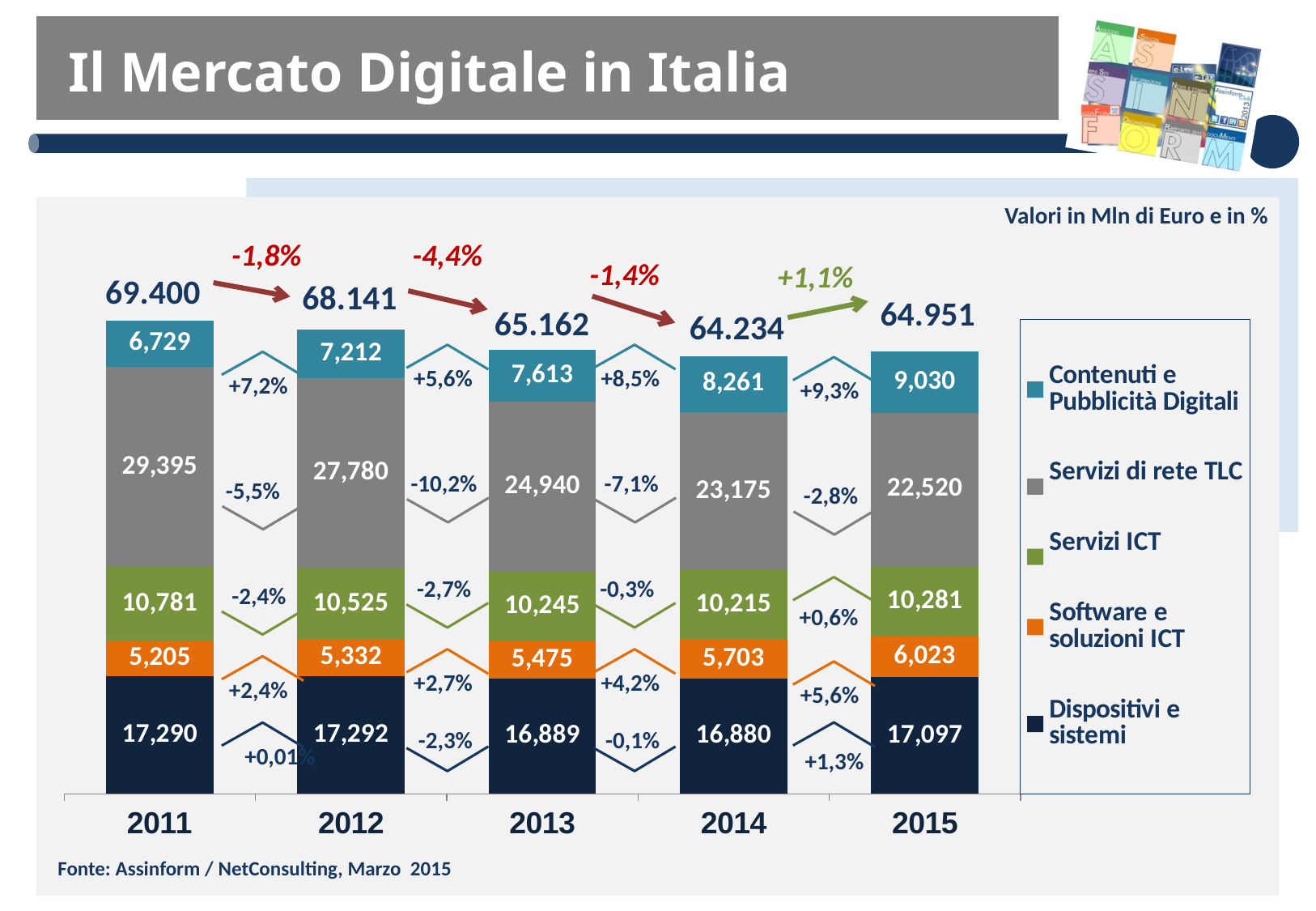
Which year has the lowest total value? 2014 What kind of chart is shown on the slide? Stacked bar chart What is the value for Servizi di rete TLC in 2013? 24,940 Does the value for Servizi di rete TLC rise or fall from 2011 to 2015? Fall Which year has the highest total value? 2011 How many series does the legend list? 5 How many years are shown on the x axis? 5 In 2011, which is larger: Servizi di rete TLC or Dispositivi e sistemi? Servizi di rete TLC What is the value for Software e soluzioni ICT in 2014? 5,703 What is the value for Contenuti e Pubblicità Digitali in 2015? 9,030 What is the total of the stacked bar for 2012? 68.141 What is the difference between the Contenuti e Pubblicità Digitali value in 2015 and in 2011? 2,301